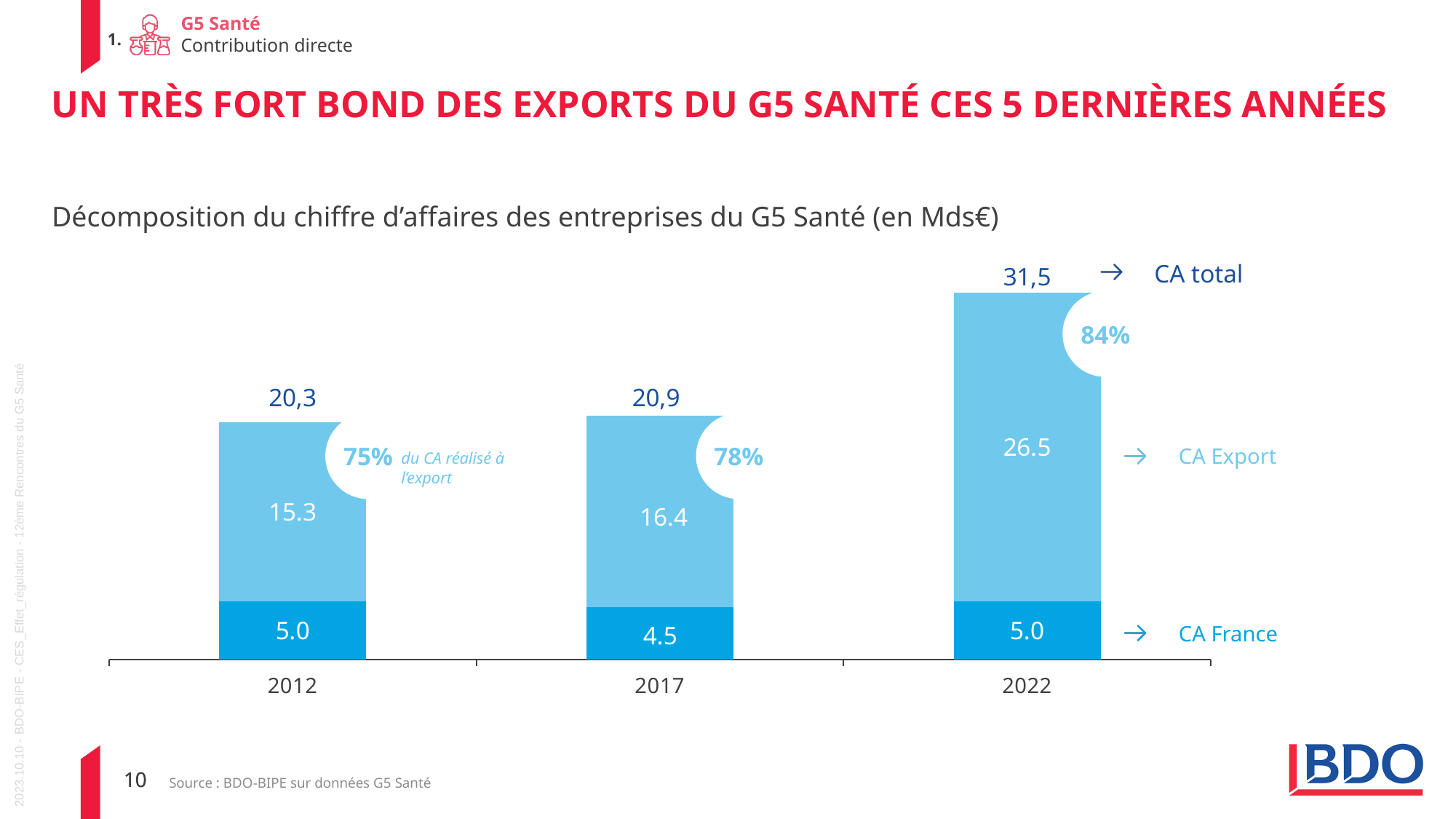
What percentage of CA is realised at export in 2017? 78% Is the CA Export value larger in 2012 or in 2017? 2017 How many years are shown on the x axis? 3 What is the CA France value for 2017? 4.5 Does the CA total rise or fall from 2012 to 2022? Rise What type of chart is shown on the slide? Stacked bar chart What is the title of the chart? Décomposition du chiffre d'affaires des entreprises du G5 Santé (en Mds€) What is the difference between the CA Export values for 2022 and 2017? 10.1 What is the CA Export value for 2022? 26.5 Which year has the lowest CA France value? 2017 What is the CA total shown above the 2012 bar? 20,3 Which year has the highest CA total? 2022